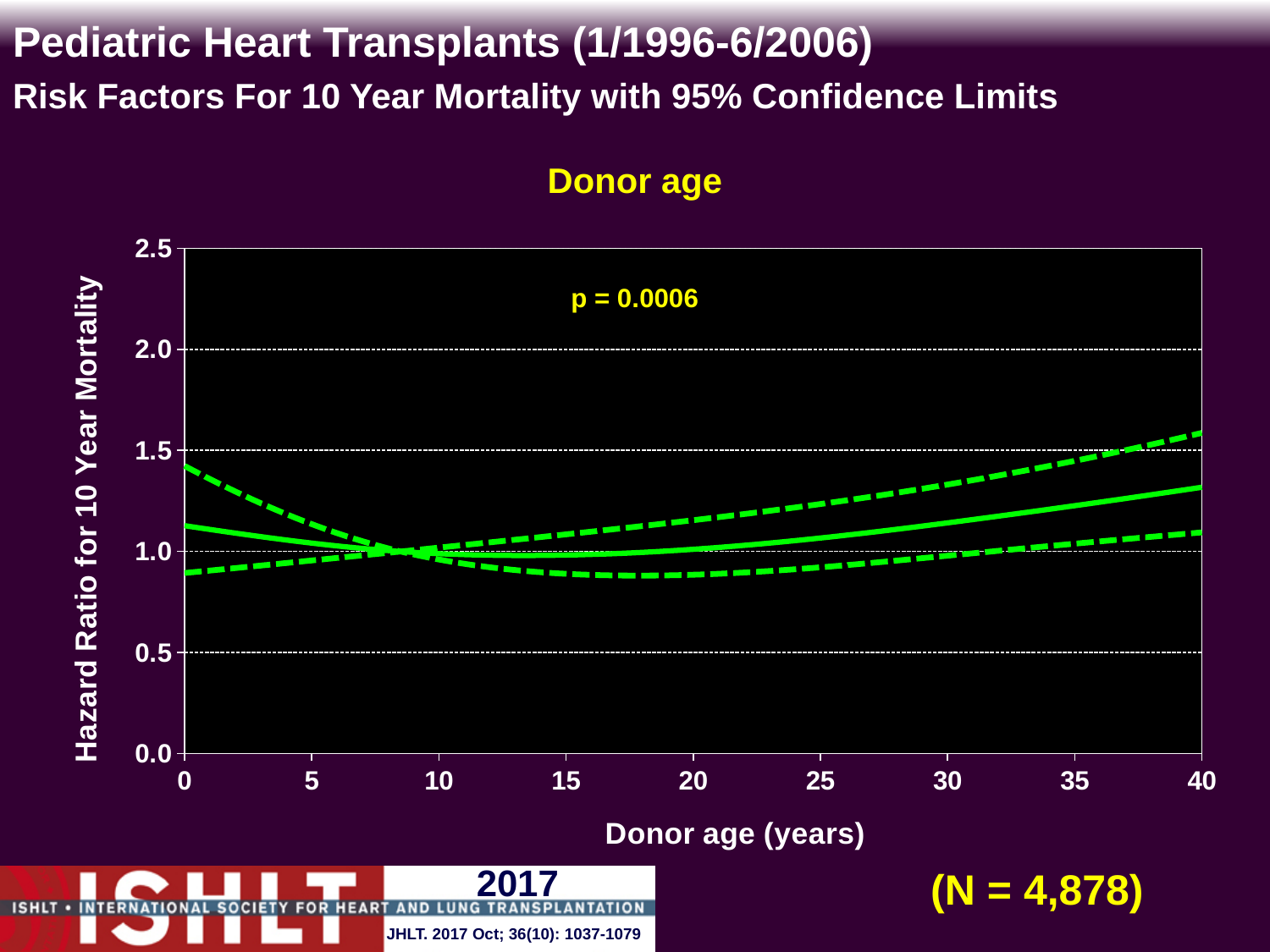
How many lines are plotted on the chart? 3 Is the lower 95% confidence limit (lower dashed line) at a donor age of 20 years greater or less than 1.0? less Is the hazard ratio (solid line) at a donor age of 0 years greater or less than 1.0? greater What is the p-value printed on the chart? p = 0.0006 What kind of chart is shown on the slide? line chart What is the highest value shown on the y axis? 2.5 Does the hazard ratio (solid line) rise or fall as donor age increases from 0 to 5 years? fall How many tick labels are shown on the x axis? 9 Does the hazard ratio (solid line) rise or fall as donor age increases from 10 to 40 years? rise What is the sample size (N) shown on the slide? N = 4,878 Is the upper 95% confidence limit (upper dashed line) at a donor age of 0 years greater or less than 1.5? less